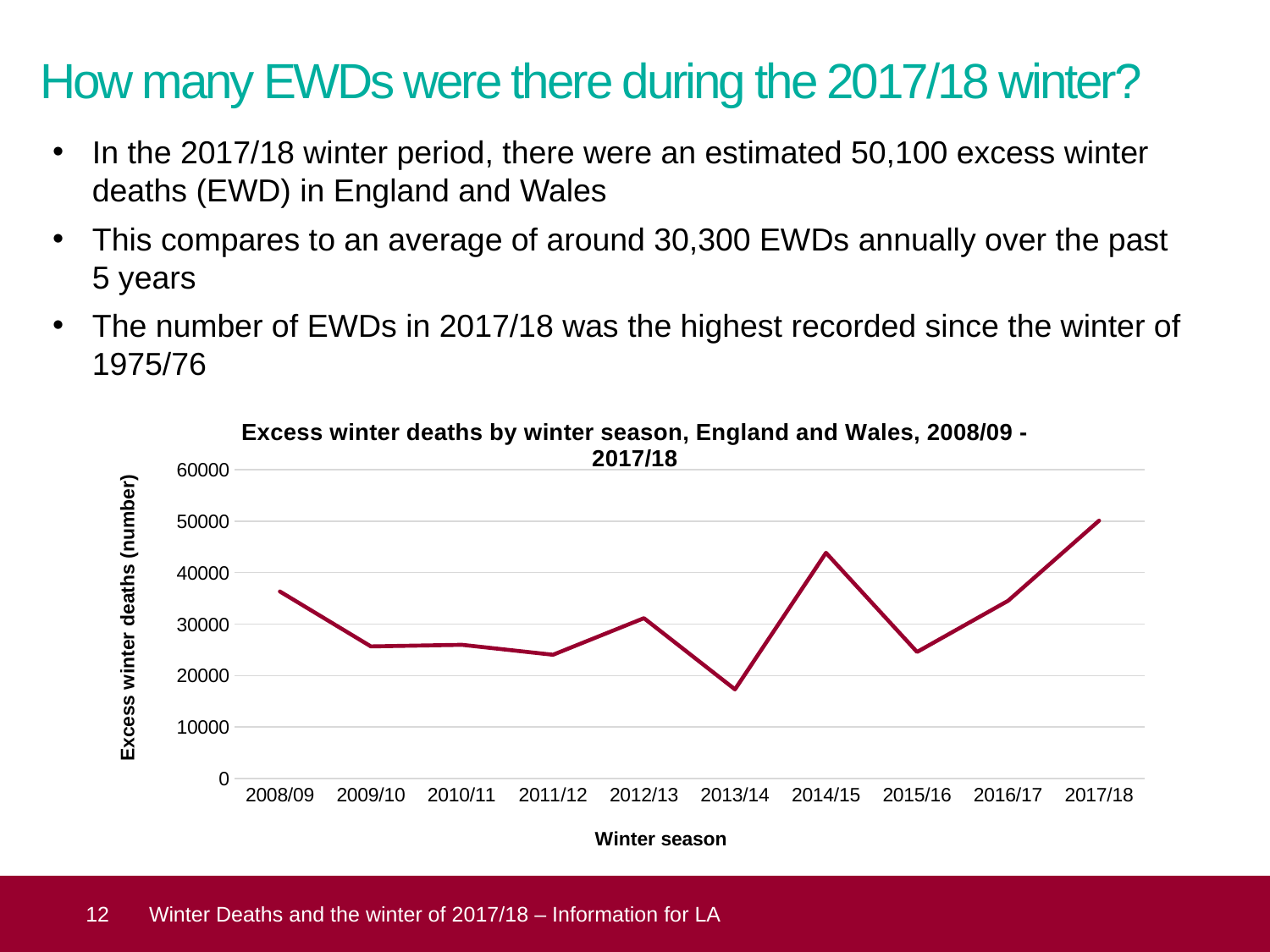
Is the value for 2008/09 greater or less than 30000? greater How many winter seasons are plotted on the x axis of the chart? 10 Is the value for 2015/16 greater or less than 30000? less What is the label on the x axis of the chart? Winter season Is the value for 2013/14 greater or less than 20000? less Do excess winter deaths rise or fall from 2015/16 to 2017/18? rise Which winter season has the lowest number of excess winter deaths in the chart? 2013/14 Which winter season has more excess winter deaths, 2012/13 or 2014/15? 2014/15 Which winter season has the highest number of excess winter deaths in the chart? 2017/18 What kind of chart is shown on the slide? line chart What is the label on the y axis of the chart? Excess winter deaths (number)